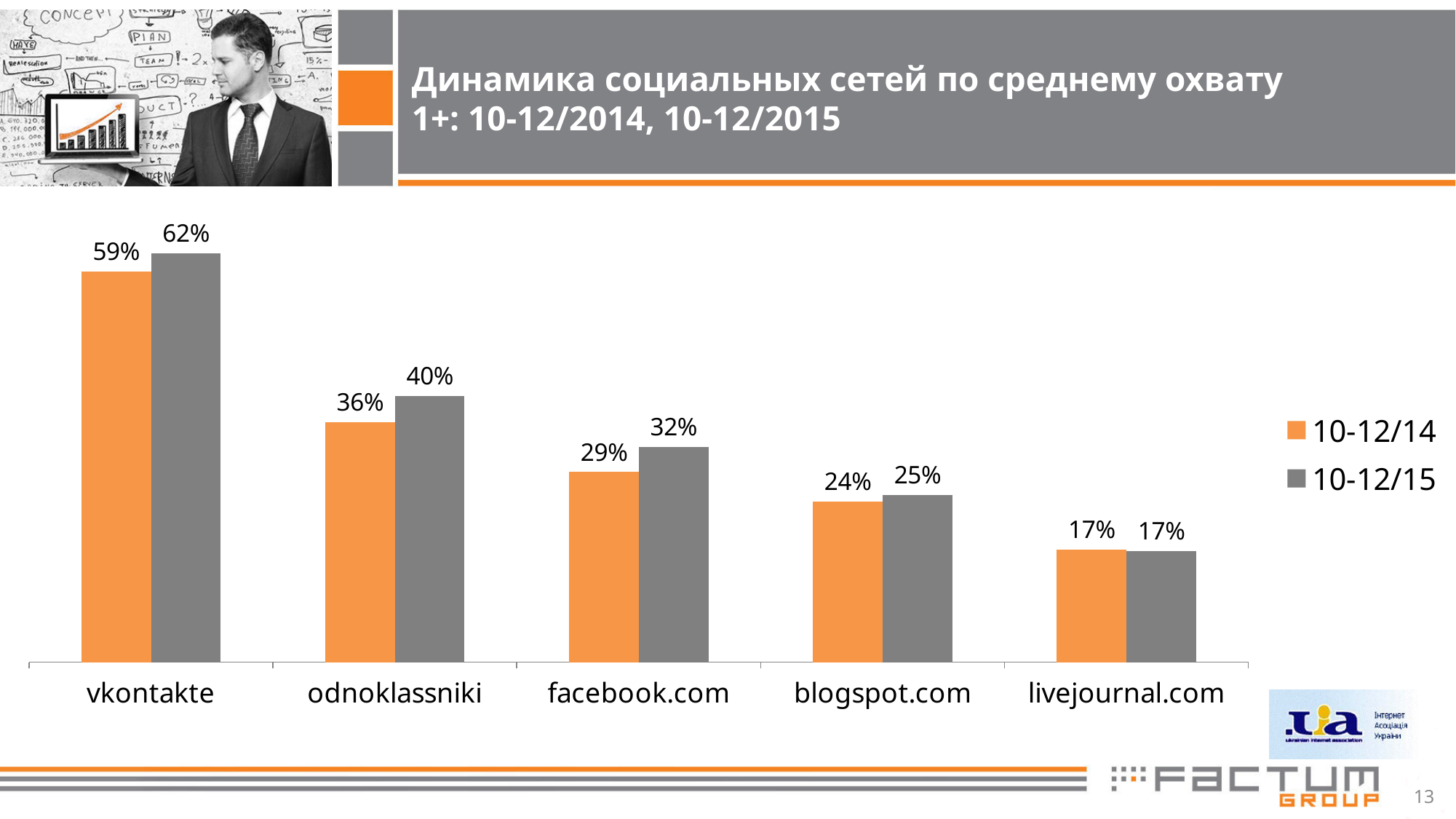
What is the value for blogspot.com in the 10-12/15 series? 25% Which category has the highest value in the 10-12/14 series? vkontakte What is the value for facebook.com in the 10-12/14 series? 29% What is the difference between the 10-12/15 and 10-12/14 values for odnoklassniki? 4% Which is larger for facebook.com: the 10-12/14 value or the 10-12/15 value? 10-12/15 Which colour represents the 10-12/14 series? orange How many categories are shown on the x axis? 5 Do the 10-12/15 values rise or fall from vkontakte to livejournal.com? fall Which category has the lowest value in the 10-12/15 series? livejournal.com What is the value for vkontakte in the 10-12/15 series? 62% How many series does the legend list? 2 What kind of chart is shown on the slide? bar chart